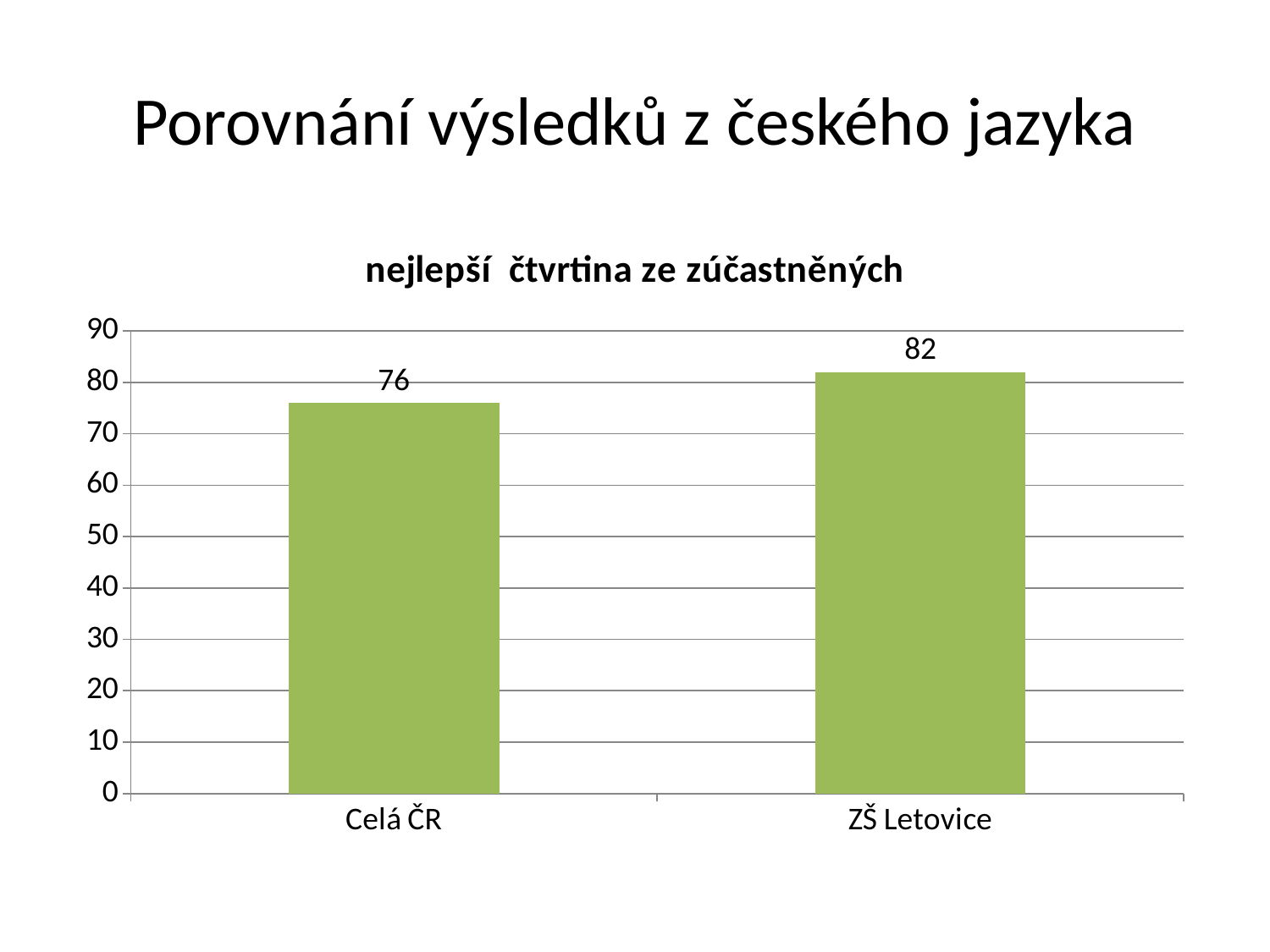
What is the value for ZŠ Letovice? 82 How many categories are shown on the chart? 2 Which category has the highest value? ZŠ Letovice What is the highest value shown on the vertical axis? 90 Which is larger, the value for Celá ČR or the value for ZŠ Letovice? ZŠ Letovice Is the value for Celá ČR greater or less than 80? less Which category has the lowest value? Celá ČR Is the value for ZŠ Letovice greater or less than 80? greater What is the difference between the values for ZŠ Letovice and Celá ČR? 6 What kind of chart is shown on the slide? bar chart What is the value for Celá ČR? 76 What is the title of the chart? nejlepší čtvrtina ze zúčastněných